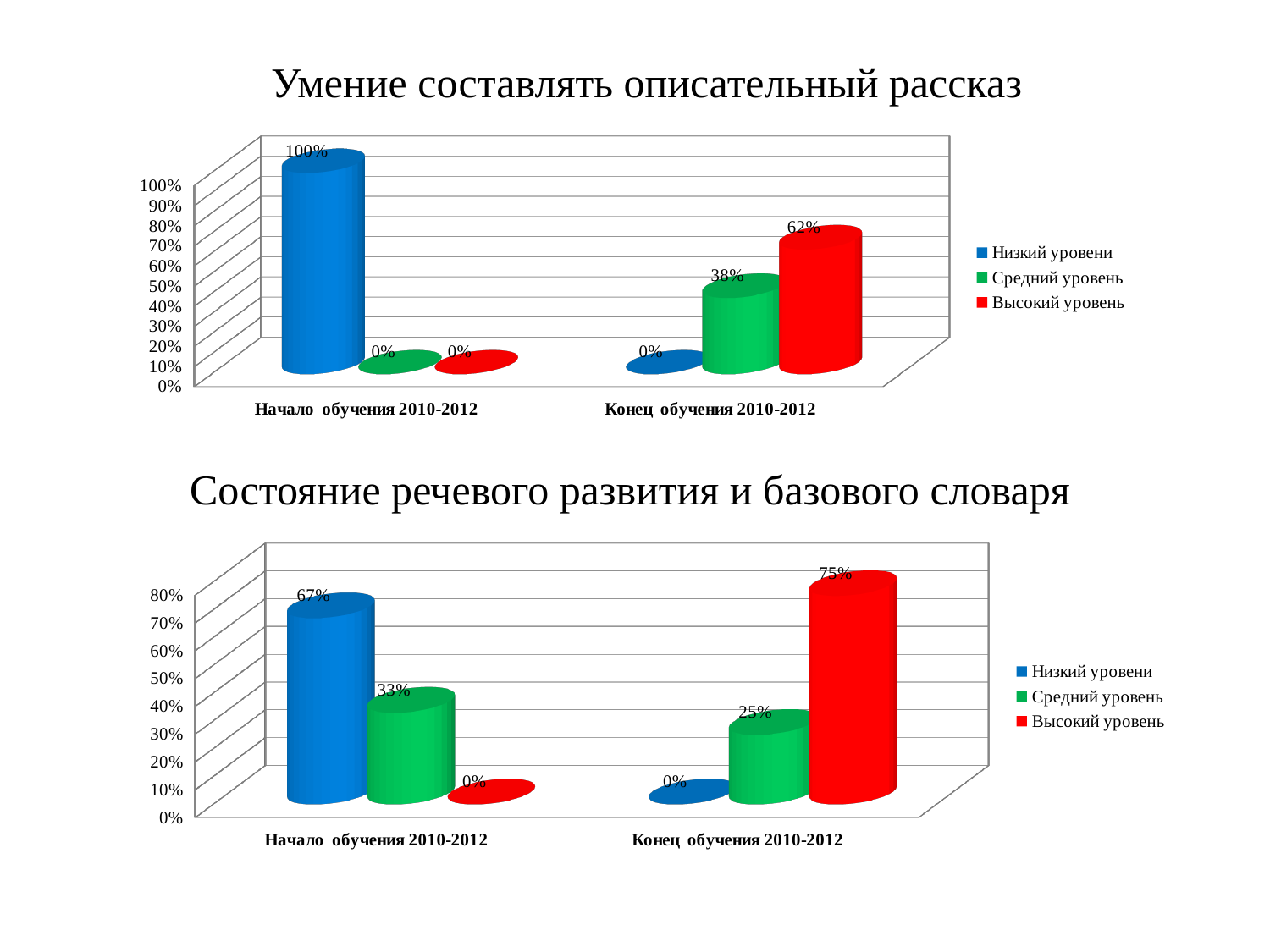
How many series does the legend of the top chart list? 3 In the bottom chart (Состояние речевого развития и базового словаря), what is the value for Средний уровень at Конец обучения 2010-2012? 25% In the bottom chart (Состояние речевого развития и базового словаря), what is the difference between Низкий уровени and Средний уровень at Начало обучения 2010-2012? 34% In the top chart (Умение составлять описательный рассказ), what is the difference between Высокий уровень and Средний уровень at Конец обучения 2010-2012? 24% In the bottom chart (Состояние речевого развития и базового словаря), which is larger at Начало обучения 2010-2012: Низкий уровени or Средний уровень? Низкий уровени In the top chart (Умение составлять описательный рассказ), what is the value for Низкий уровени at Начало обучения 2010-2012? 100% In the top chart (Умение составлять описательный рассказ), what is the value for Средний уровень at Конец обучения 2010-2012? 38% What kind of chart is the bottom chart (Состояние речевого развития и базового словаря)? Bar chart In the top chart (Умение составлять описательный рассказ), what is the value for Высокий уровень at Конец обучения 2010-2012? 62% In the top chart (Умение составлять описательный рассказ), which series has the highest value at Конец обучения 2010-2012? Высокий уровень In the bottom chart (Состояние речевого развития и базового словаря), what is the value for Высокий уровень at Конец обучения 2010-2012? 75% In the bottom chart (Состояние речевого развития и базового словаря), what is the value for Низкий уровени at Начало обучения 2010-2012? 67%